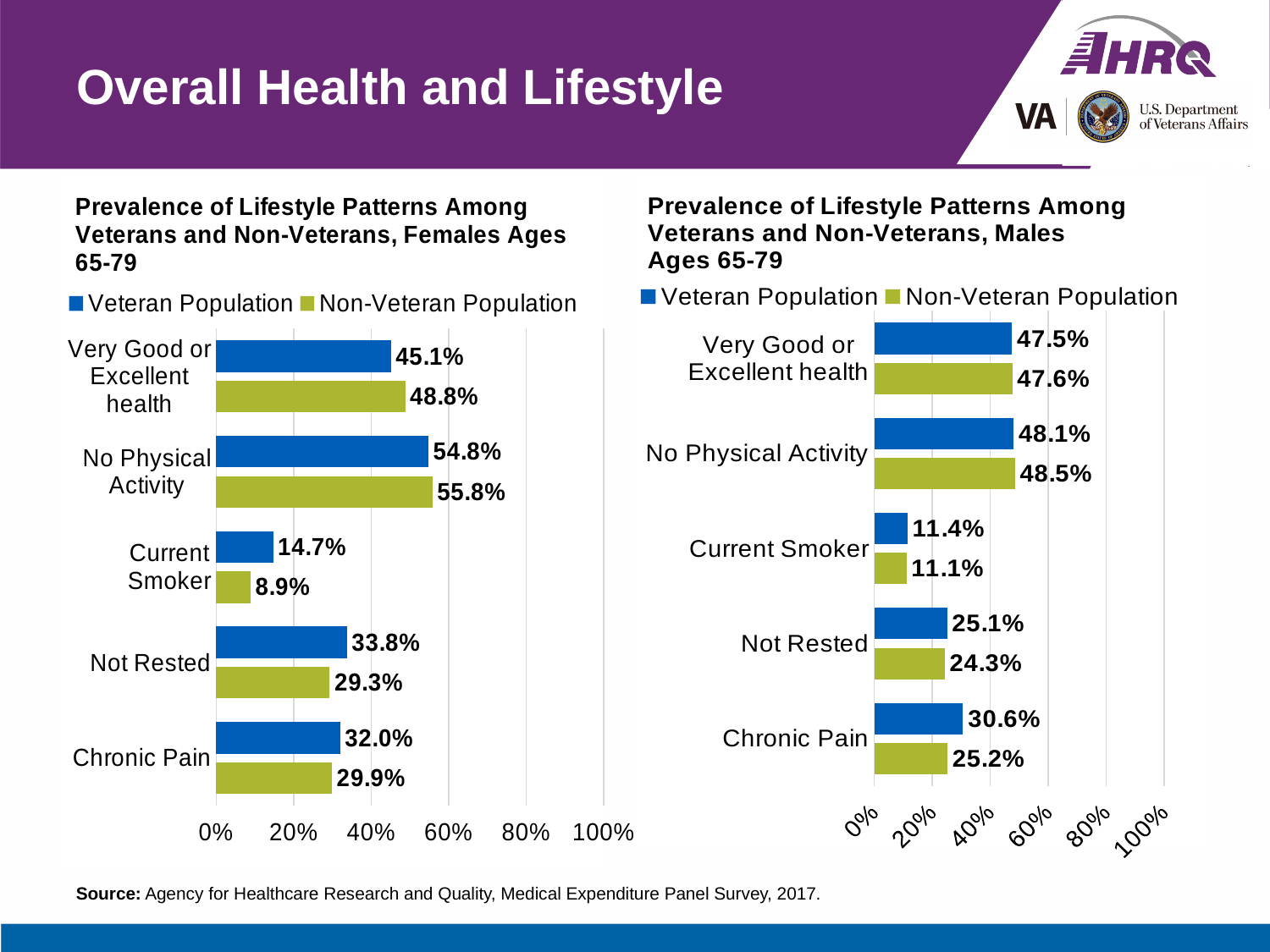
In the Males Ages 65-79 chart, which category has the lowest Veteran Population value? Current Smoker In the Females Ages 65-79 chart, which category has the highest Non-Veteran Population value? No Physical Activity In the Females Ages 65-79 chart, what is the Veteran Population value for Current Smoker? 14.7% What type of chart is the Females Ages 65-79 chart? Bar chart In the Males Ages 65-79 chart, what is the Non-Veteran Population value for Chronic Pain? 25.2% How many categories are shown in the Females Ages 65-79 chart? 5 In the Females Ages 65-79 chart, which is larger for Not Rested: the Veteran Population value or the Non-Veteran Population value? Veteran Population In the Females Ages 65-79 chart, what is the difference between the Veteran and Non-Veteran Population values for Current Smoker? 5.8% In the Males Ages 65-79 chart, which colour represents the Non-Veteran Population? Green How many series does the legend of the Males Ages 65-79 chart list? 2 In the Males Ages 65-79 chart, what is the difference between the Veteran and Non-Veteran Population values for Chronic Pain? 5.4% In the Males Ages 65-79 chart, is the Veteran Population value for No Physical Activity greater or less than 40%? greater